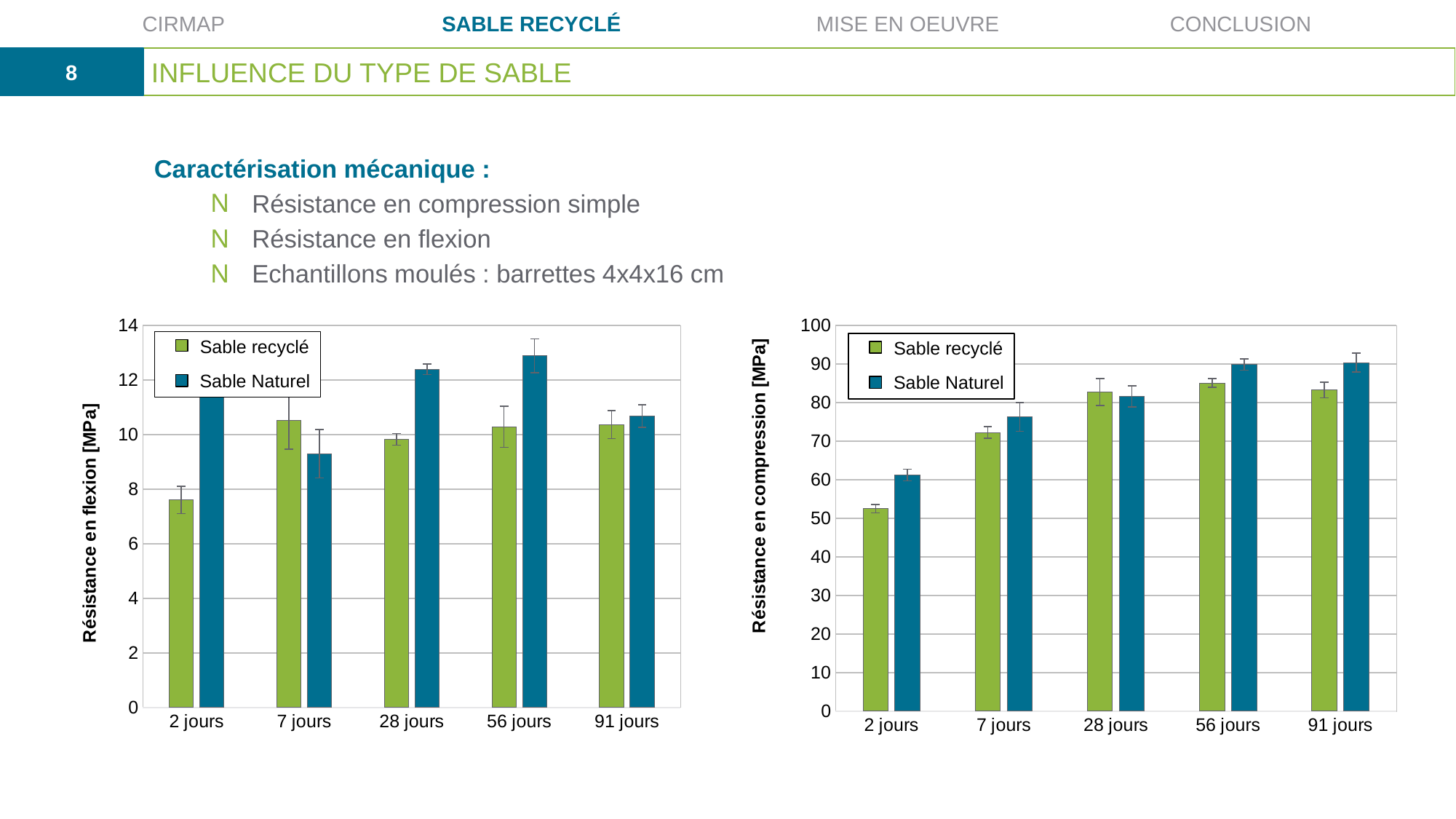
What is the y-axis label of the right chart? Résistance en compression [MPa] How many series does the legend of the left chart (Résistance en flexion) list? 2 In the left chart (Résistance en flexion), is the value for Sable Naturel at 56 jours greater or less than 12? greater In the right chart (Résistance en compression), which is larger at 2 jours: Sable recyclé or Sable Naturel? Sable Naturel What kind of chart is the left chart (Résistance en flexion)? bar chart In the left chart (Résistance en flexion), at which age is the Sable Naturel value lowest? 7 jours In the right chart (Résistance en compression), do the Sable Naturel values generally rise or fall from 2 jours to 91 jours? rise In the right chart (Résistance en compression), is the value for Sable recyclé at 2 jours greater or less than 60? less In the right chart (Résistance en compression), at which age is the Sable recyclé value lowest? 2 jours In the left chart (Résistance en flexion), is the value for Sable recyclé at 2 jours greater or less than 8? less In the left chart (Résistance en flexion), which is larger at 7 jours: Sable recyclé or Sable Naturel? Sable recyclé How many categories are shown on the x axis of the right chart (Résistance en compression)? 5